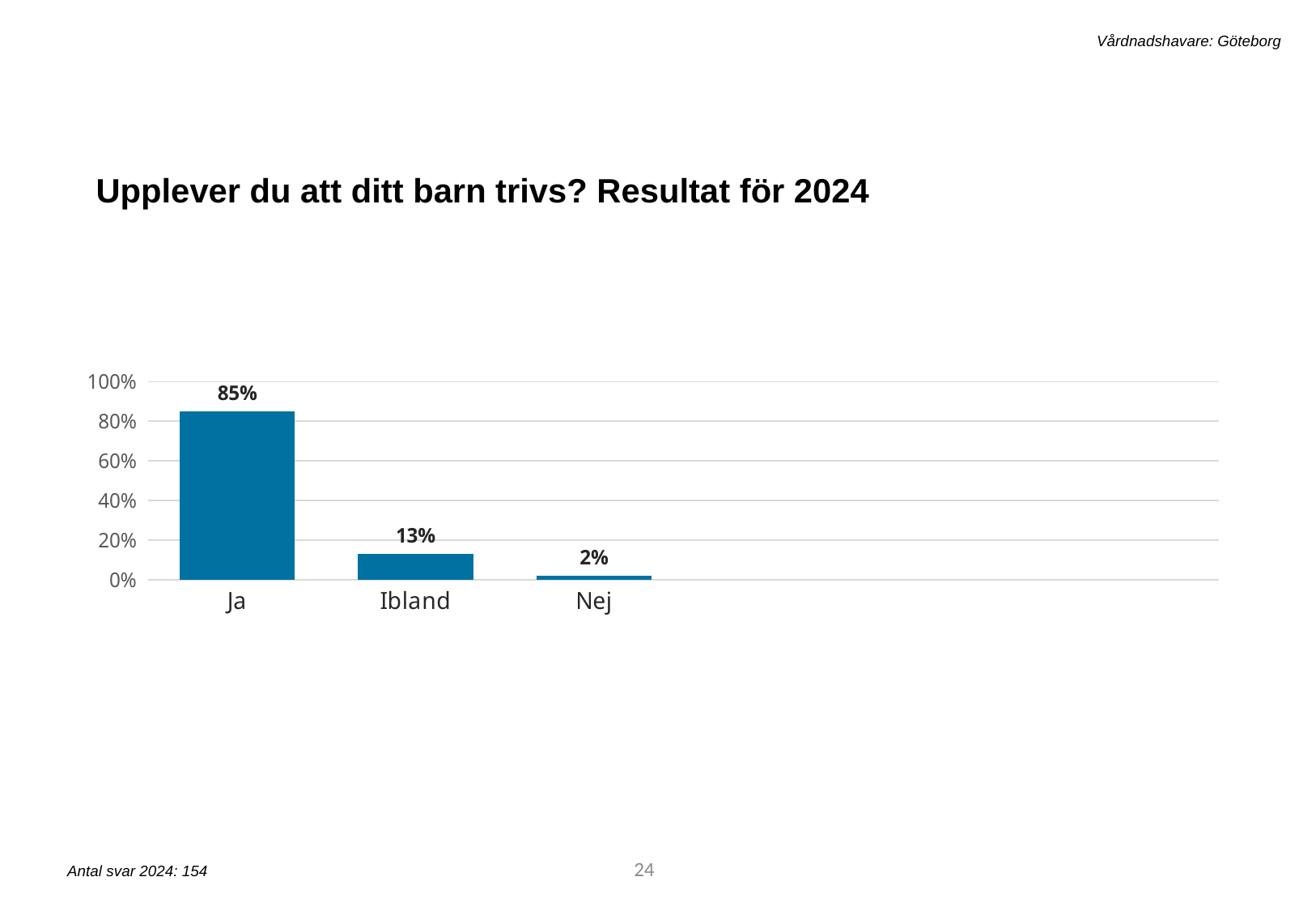
What is the value for Nej? 2% How many categories are shown on the x axis? 3 Which is larger, the value for Ibland or the value for Nej? Ibland Which category has the lowest value? Nej Is the value for Ja greater or less than 80%? greater What is the difference between the values for Ja and Ibland? 72% What is the difference between the values for Ibland and Nej? 11% What kind of chart is shown on the slide? bar chart What is the title of the chart on the slide? Upplever du att ditt barn trivs? Resultat för 2024 What is the value for Ja? 85% What is the value for Ibland? 13% Which category has the highest value? Ja